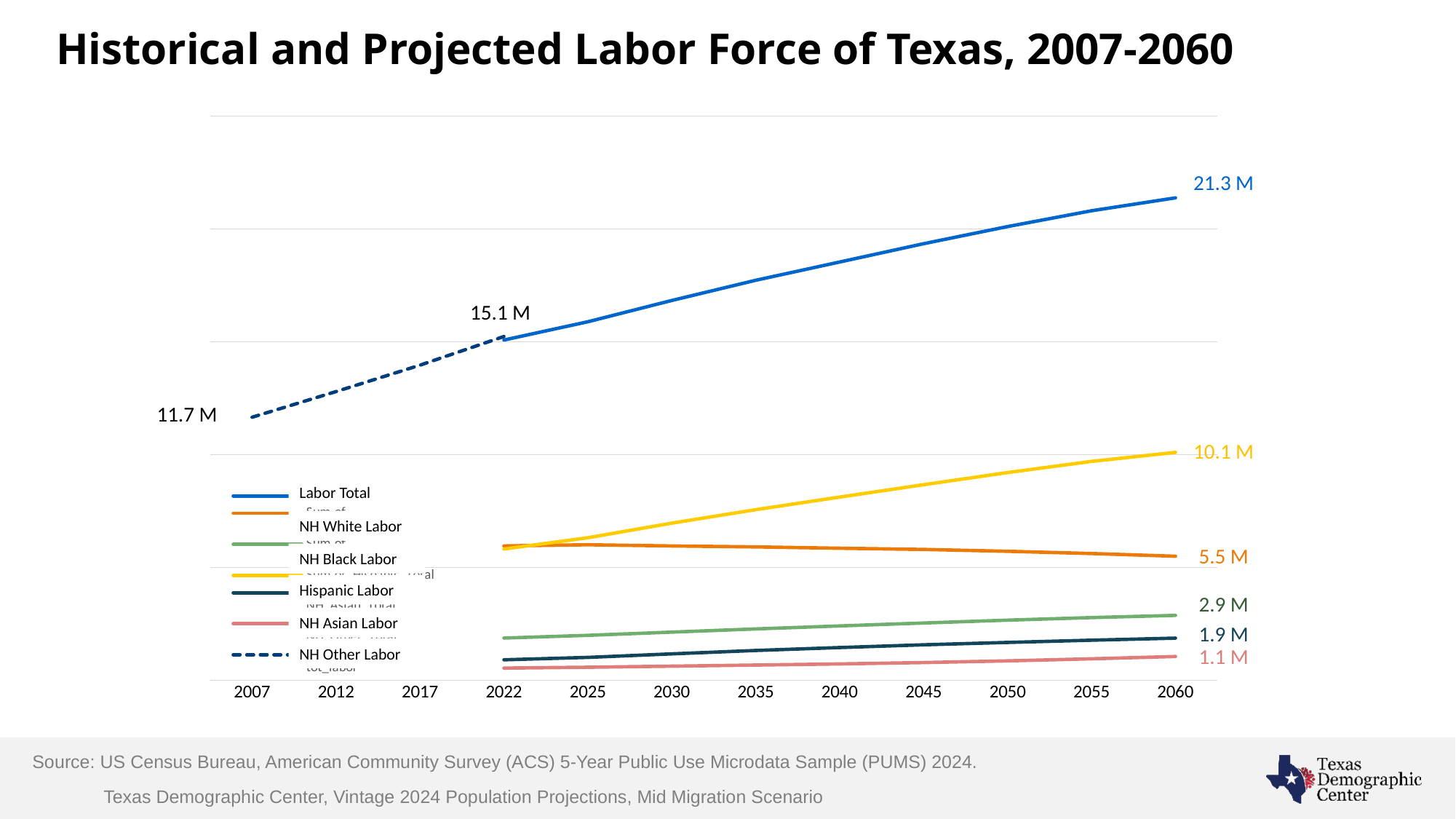
How much did the Labor Total increase from 2007 to 2022? 3.4 M What is the difference between the 2060 Hispanic Labor and NH White Labor values? 4.6 M Does the NH White Labor line rise or fall between 2022 and 2060? Fall What was the Labor Total in 2022? 15.1 M Which race/ethnicity group has the largest projected labor force in 2060? Hispanic Labor What is the projected Hispanic Labor value in 2060? 10.1 M What kind of chart is shown on the slide? Line chart What is the projected NH White Labor value in 2060? 5.5 M What was the Labor Total in 2007? 11.7 M What is the projected Labor Total for Texas in 2060? 21.3 M By how much is the Labor Total projected to grow between 2022 and 2060? 6.2 M Which race/ethnicity group has the smallest projected labor force in 2060? NH Other Labor